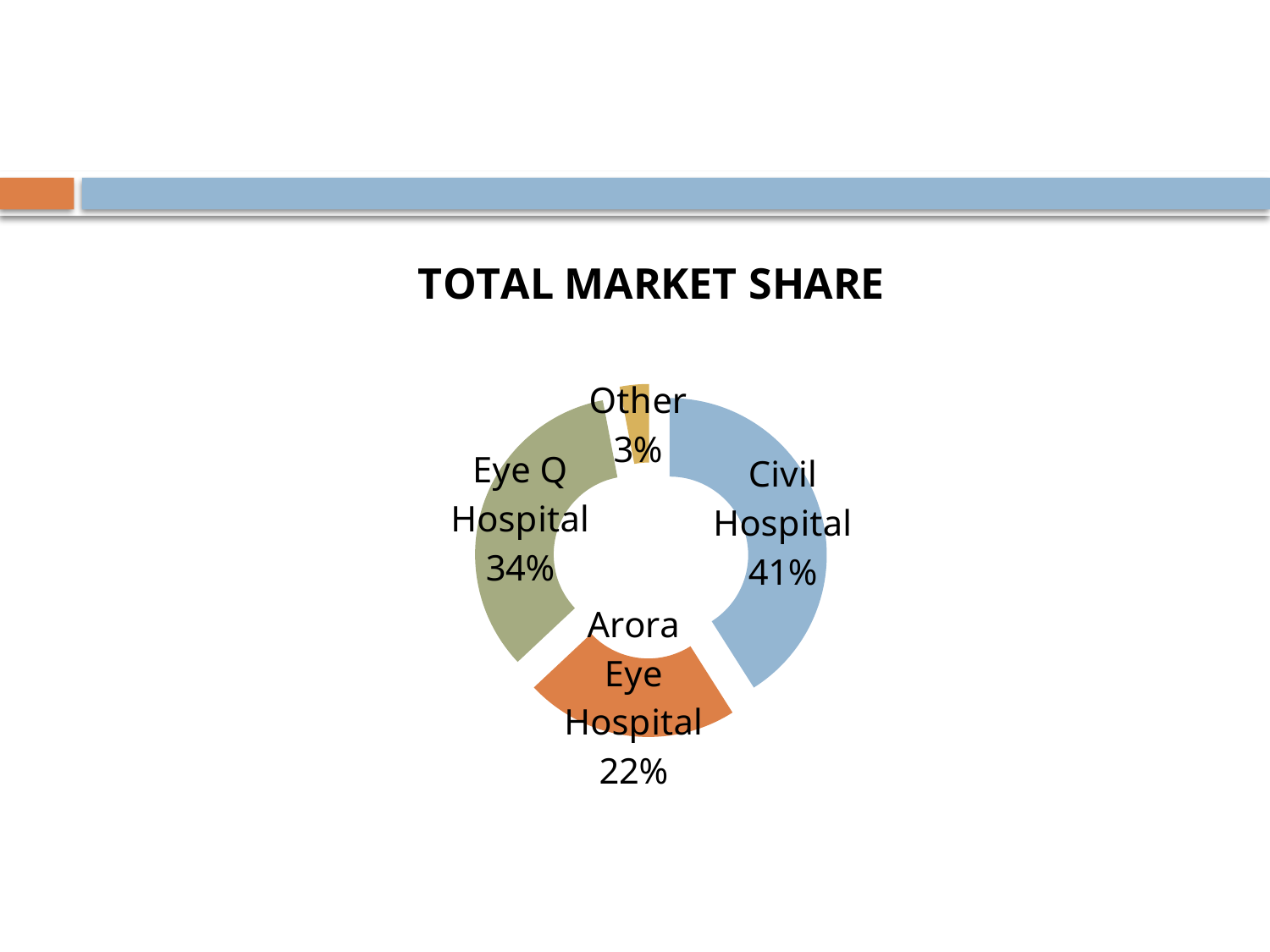
What is the market share of Arora Eye Hospital? 22% What is the market share of Civil Hospital? 41% What is the difference in market share between Eye Q Hospital and Arora Eye Hospital? 12% Which category has the smallest market share? Other What kind of chart is shown on the slide? Doughnut (pie) chart Which category has the largest market share? Civil Hospital What is the difference in market share between Civil Hospital and Eye Q Hospital? 7% What is the market share labelled Other? 3% What is the title of the chart? TOTAL MARKET SHARE What is the market share of Eye Q Hospital? 34% Which has a larger market share, Arora Eye Hospital or Eye Q Hospital? Eye Q Hospital How many categories are shown in the chart? 4